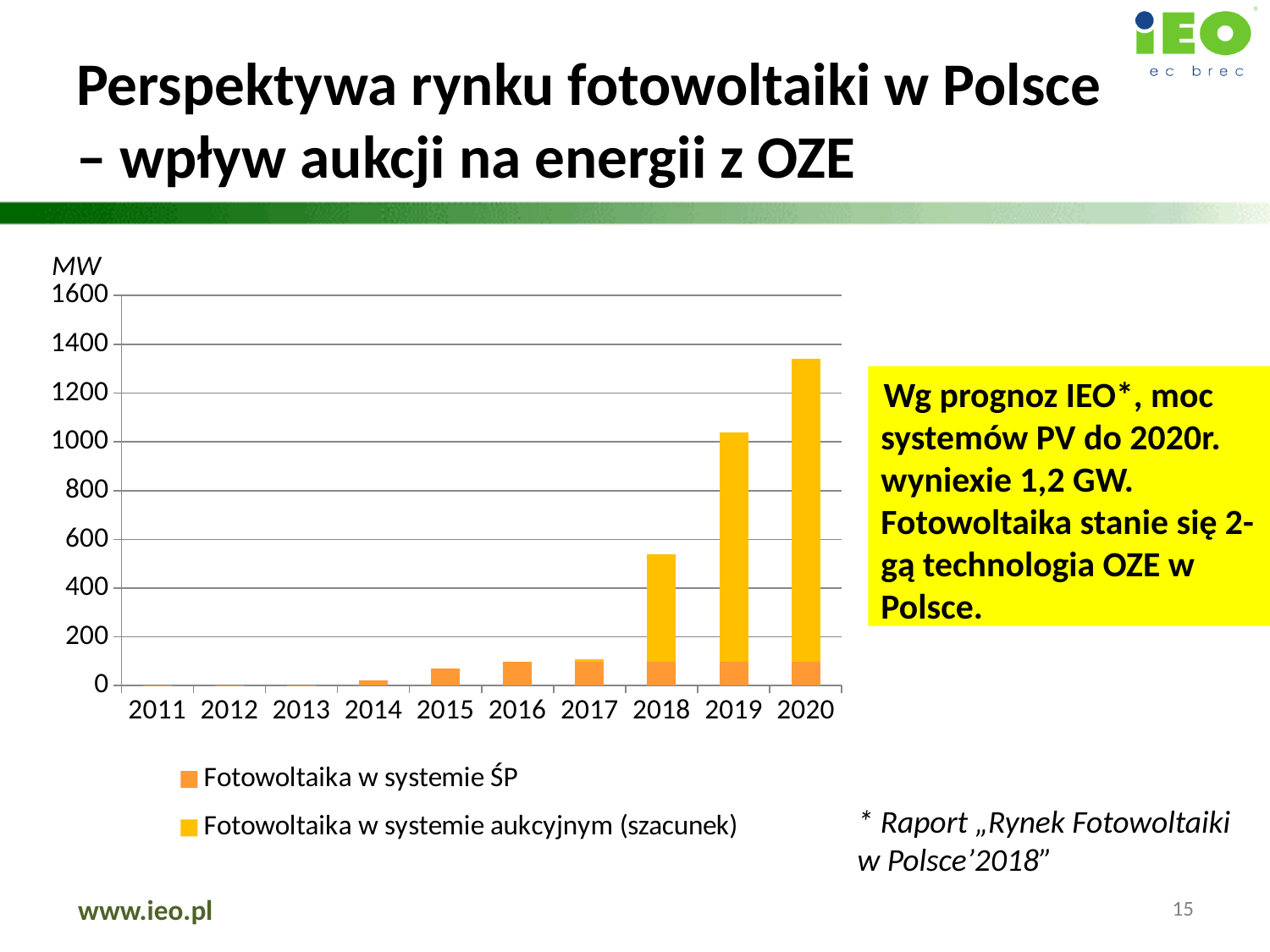
Which year has the highest total bar in the chart? 2020 Is the total value for 2017 greater or less than 200? less Is the total value for 2018 greater or less than 400? greater Is the total value for 2019 greater or less than 800? greater What unit is shown at the top of the y axis? MW What is the name of the series shown in the darker orange colour in the legend? Fotowoltaika w systemie ŚP How many series does the chart legend list? 2 Which year has the larger total bar, 2018 or 2019? 2019 What kind of chart is shown on the slide? bar chart Do the total values generally rise or fall from 2011 to 2020? rise How many years are shown on the x axis of the chart? 10